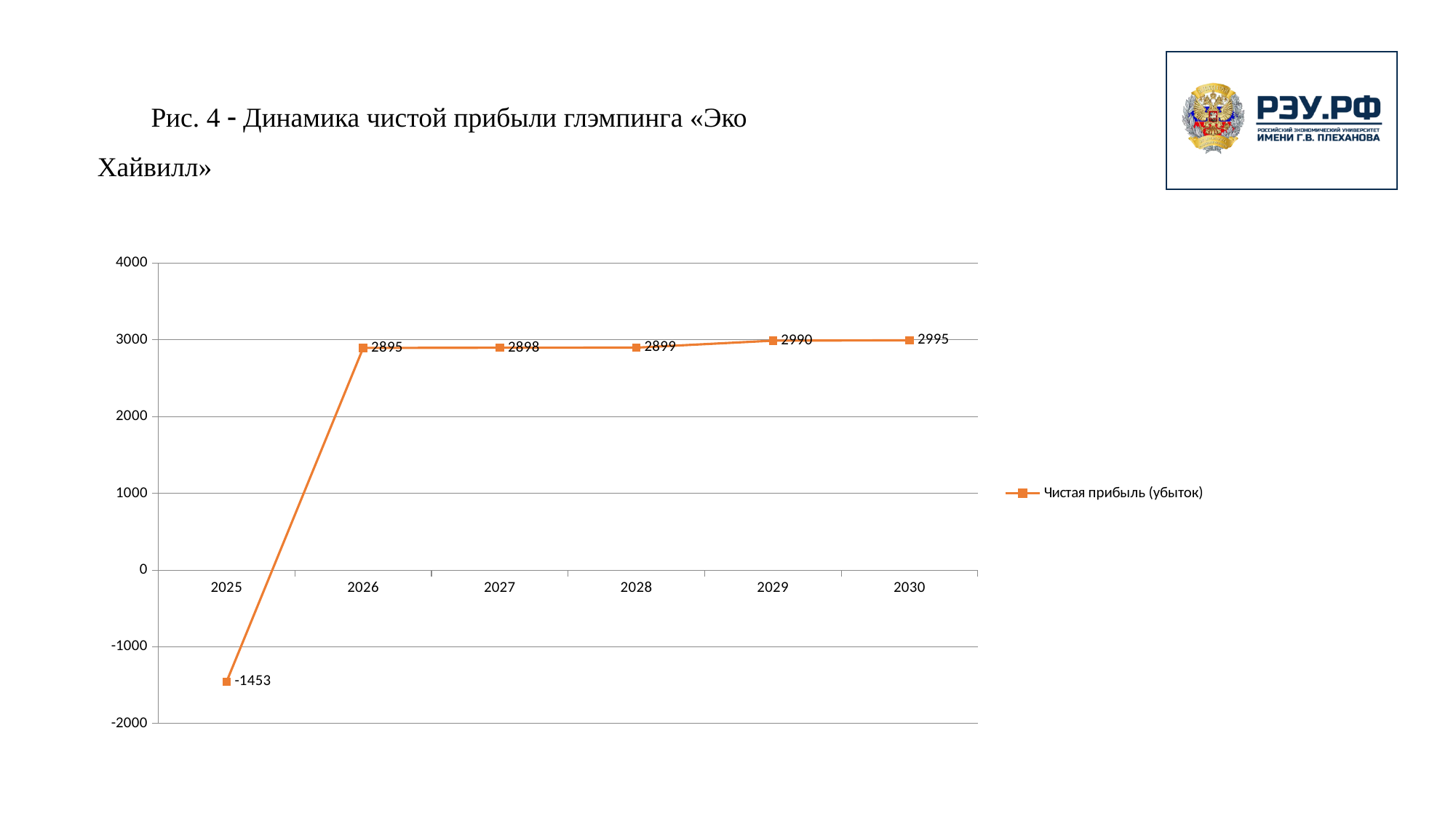
What series name does the legend list? Чистая прибыль (убыток) Which year has the lowest net profit value? 2025 What is the net profit value for 2029? 2990 What kind of chart is shown on the slide? line chart What is the net profit value for 2026? 2895 What is the net profit value for 2030? 2995 What is the net profit (Чистая прибыль) value for 2025? -1453 Which year has the highest net profit value? 2030 Which year has the larger net profit value, 2028 or 2029? 2029 What is the difference between the net profit values for 2030 and 2026? 100 How many years are plotted on the x axis? 6 Is the value for 2027 greater or less than 2000? greater